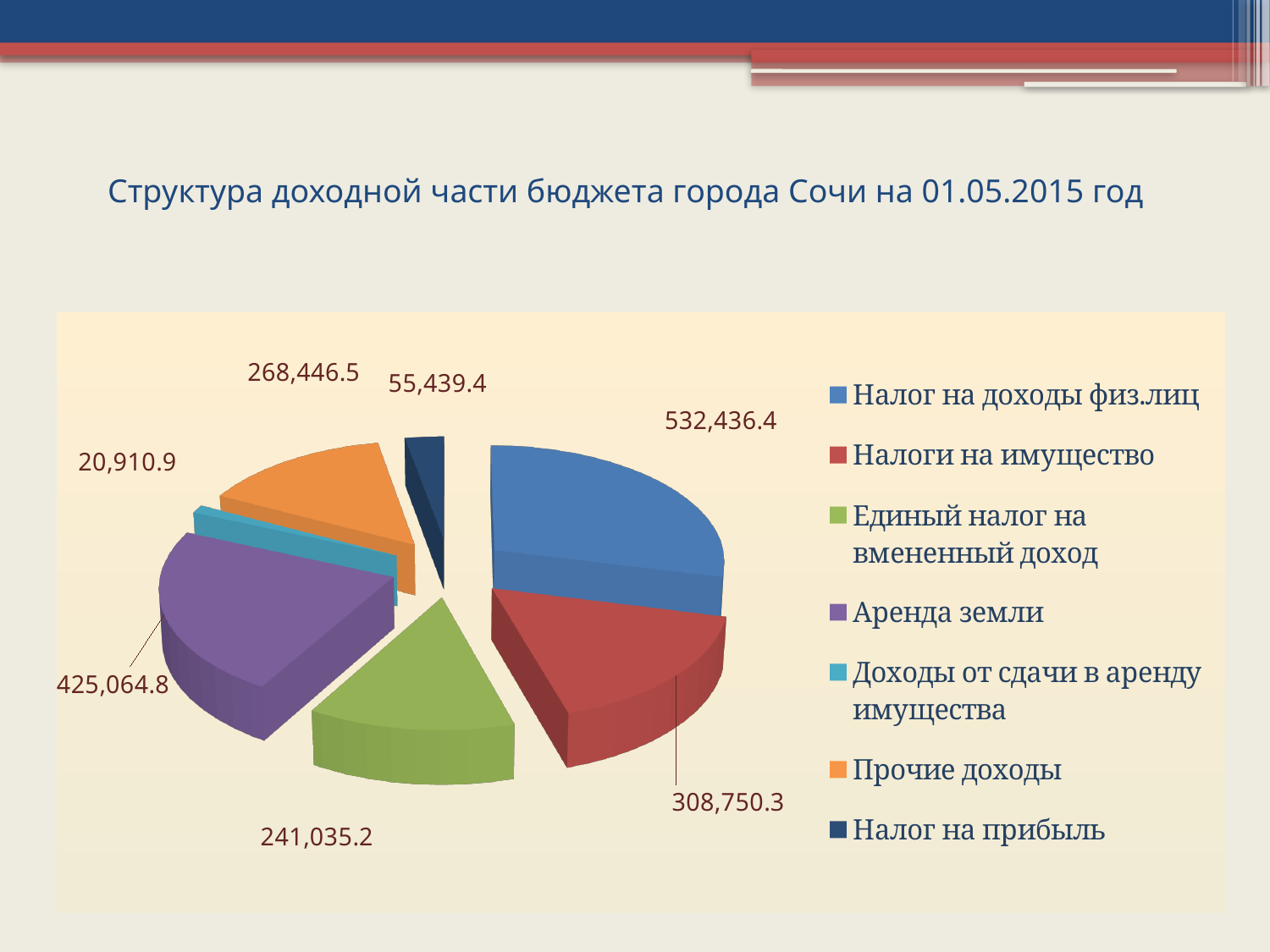
How many categories does the pie chart show? 7 What is the value for Доходы от сдачи в аренду имущества? 20,910.9 What is the value for Аренда земли? 425,064.8 Which is larger, Прочие доходы or Налог на прибыль? Прочие доходы What kind of chart is shown on the slide? Pie chart What is the difference between Налог на доходы физ.лиц and Налоги на имущество? 223,686.1 Which category has the smallest slice? Доходы от сдачи в аренду имущества What is the value for Налог на доходы физ.лиц? 532,436.4 What is the value for Прочие доходы? 268,446.5 What is the difference between Аренда земли and Единый налог на вмененный доход? 184,029.6 Which category has the largest slice? Налог на доходы физ.лиц What is the title of the slide? Структура доходной части бюджета города Сочи на 01.05.2015 год